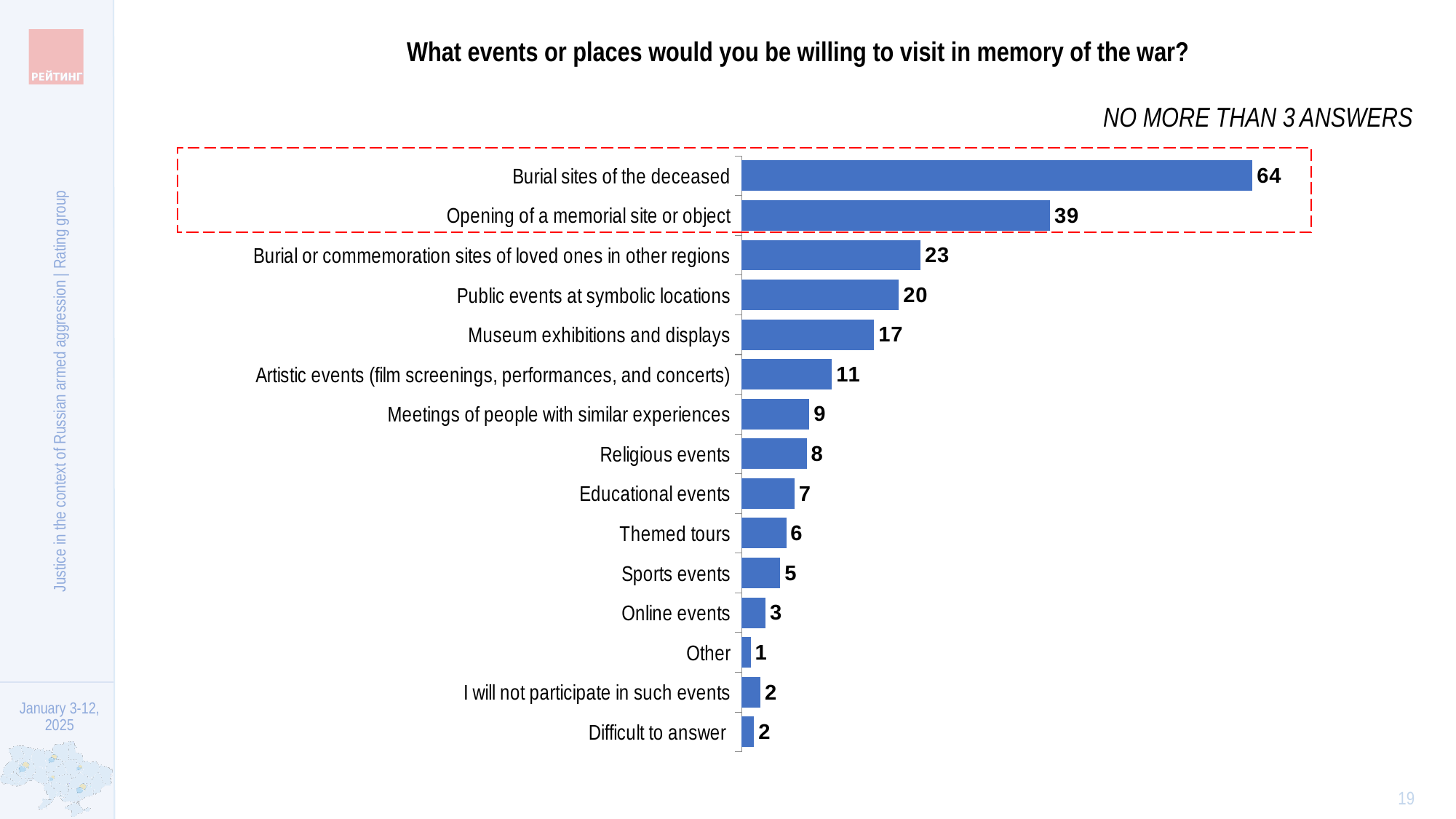
What is the value for "Religious events"? 8 What is the title of the chart? What events or places would you be willing to visit in memory of the war? Which category has the highest value? Burial sites of the deceased What is the value for "Museum exhibitions and displays"? 17 What is the value for "Burial sites of the deceased"? 64 What kind of chart is shown on the slide? Bar chart What is the value for "Themed tours"? 6 How many categories are shown in the chart? 15 Which category has the lowest value? Other What is the difference between the values for "Burial sites of the deceased" and "Opening of a memorial site or object"? 25 How many categories are enclosed by the red dashed box? 2 Which is larger: the value for "Public events at symbolic locations" or the value for "Artistic events (film screenings, performances, and concerts)"? Public events at symbolic locations